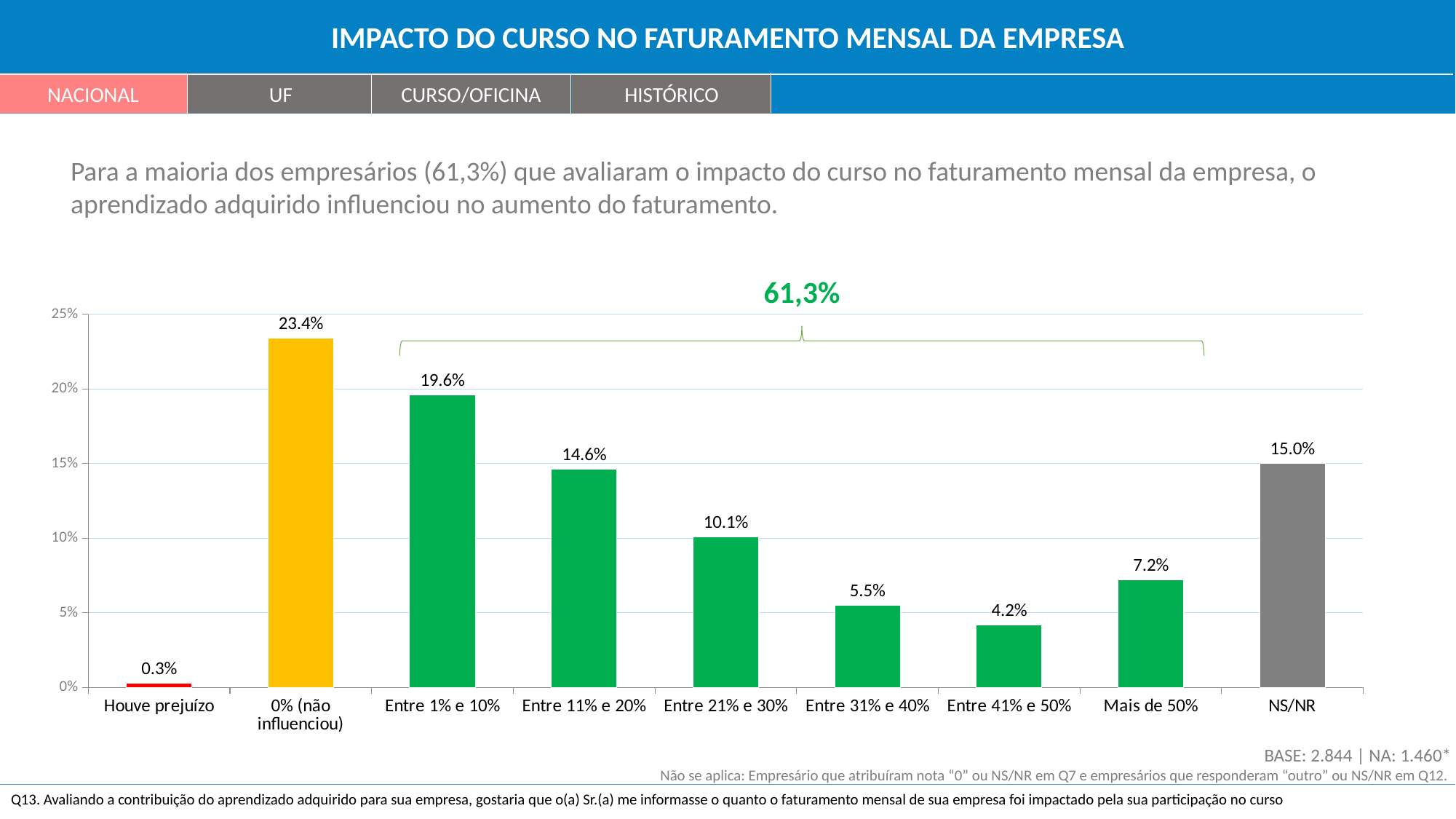
What kind of chart is shown on the slide? bar chart What is the value for "Houve prejuízo"? 0.3% What is the value for "Entre 1% e 10%"? 19.6% Which category has the highest value? 0% (não influenciou) Is the value for "Entre 31% e 40%" greater or less than 10%? less Which category has the lowest value? Houve prejuízo What is the value for "0% (não influenciou)"? 23.4% How many categories are shown on the x axis? 9 Which is larger, "Mais de 50%" or "Entre 41% e 50%"? Mais de 50% What is the difference between "Entre 11% e 20%" and "Entre 21% e 30%"? 4.5% What percentage is shown above the bracket grouping the green bars? 61,3% What is the value for "NS/NR"? 15.0%